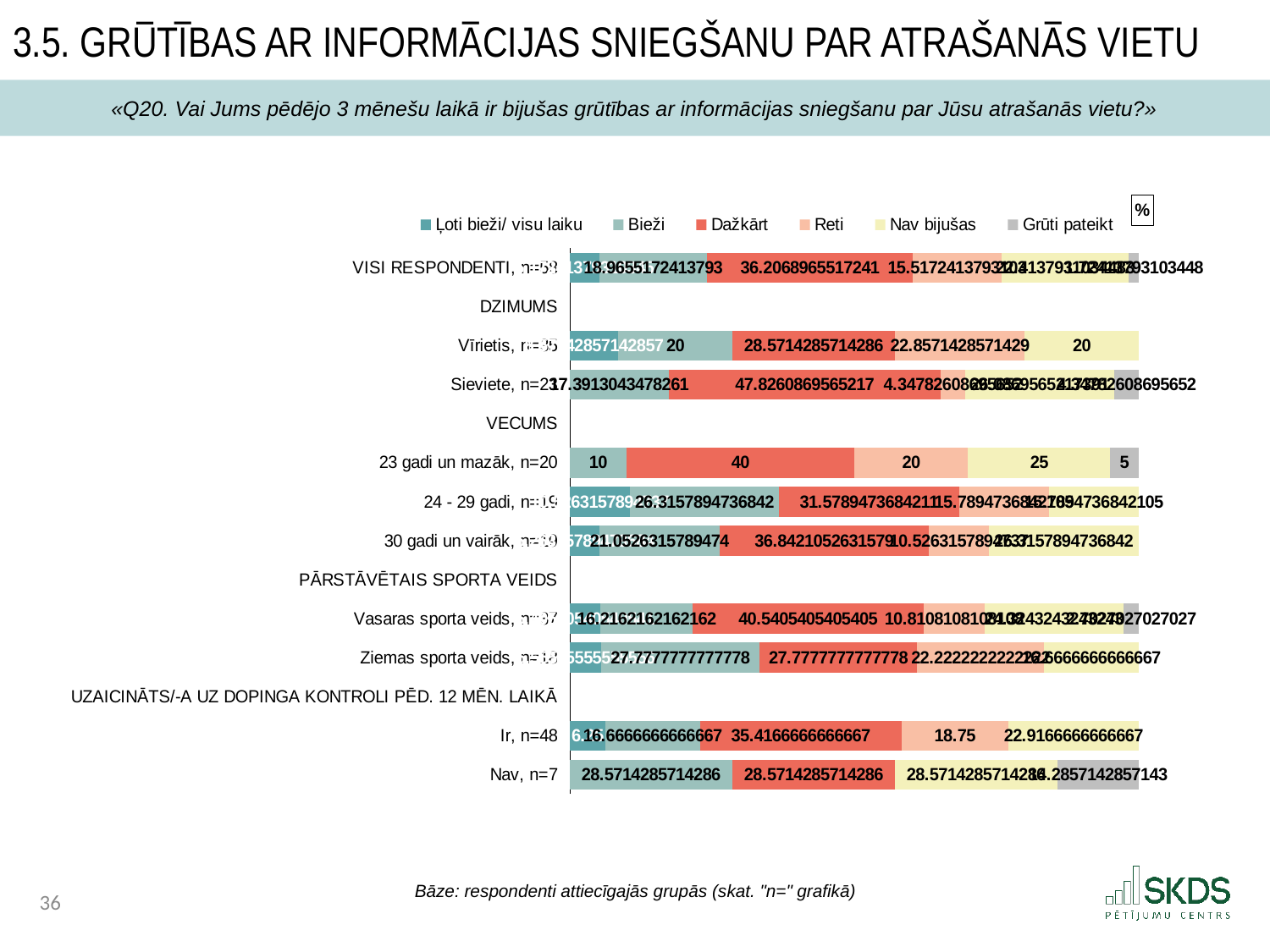
What is the value of "Nav bijušas" for "23 gadi un mazāk, n=20"? 25 Which is larger, the "Dažkārt" value for "Vīrietis, n=35" or for "Sieviete, n=23"? Sieviete, n=23 Which group has the highest value for "Dažkārt"? Sieviete, n=23 What is the first entry in the chart legend? Ļoti bieži/ visu laiku How many series does the legend list? 6 What is the value of "Dažkārt" for "Vīrietis, n=35"? 28.5714285714286 What is the value of "Reti" for "Ir, n=48"? 18.75 What is the value of "Dažkārt" for "23 gadi un mazāk, n=20"? 40 What is the difference between the "Dažkārt" and "Reti" values for "23 gadi un mazāk, n=20"? 20 What is the value of "Dažkārt" for "Sieviete, n=23"? 47.8260869565217 What is the value of "Grūti pateikt" for "23 gadi un mazāk, n=20"? 5 What kind of chart is shown on the slide? Stacked bar chart